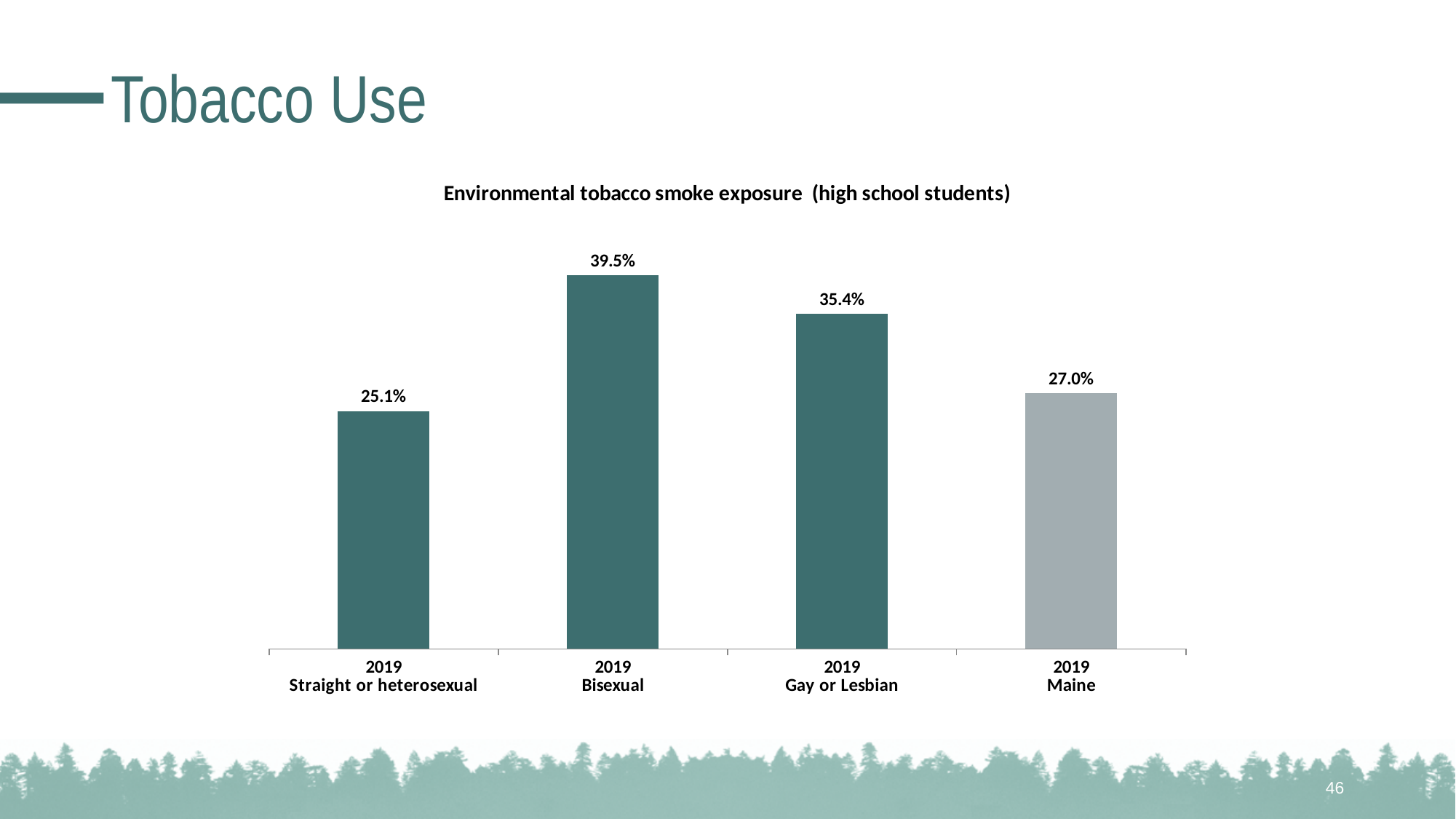
What is the value for Gay or Lesbian students? 35.4% What is the value for Maine? 27.0% What is the value for Bisexual students in the environmental tobacco smoke exposure chart? 39.5% What kind of chart is shown on the slide? Bar chart Which category has the lowest environmental tobacco smoke exposure? Straight or heterosexual How many bars are shown in the chart? 4 What is the difference between the Gay or Lesbian value and the Maine value? 8.4% What is the difference between the Bisexual and Straight or heterosexual values? 14.4% What is the title of the chart? Environmental tobacco smoke exposure (high school students) Which is larger, the value for Maine or the value for Straight or heterosexual? Maine Which category has the highest environmental tobacco smoke exposure? Bisexual What is the value for Straight or heterosexual students? 25.1%